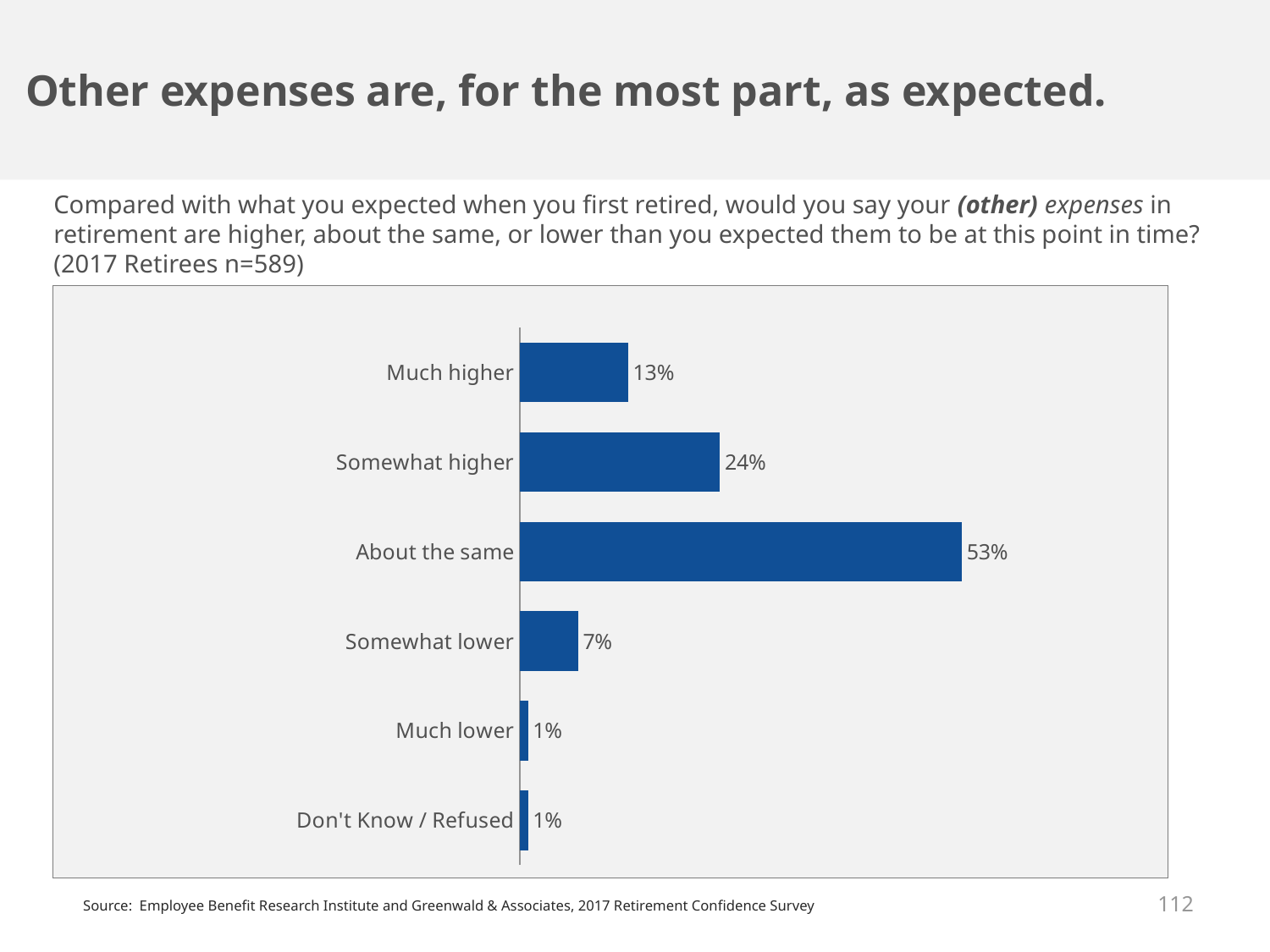
What percentage of retirees said their other expenses are about the same as expected? 53% Which response category has the highest percentage? About the same What percentage of retirees said their other expenses are somewhat lower than expected? 7% What is the sample size of 2017 retirees shown for this question? 589 What is the combined percentage of retirees who said their other expenses are much higher or somewhat higher than expected? 37% What is the difference in percentage points between 'About the same' and 'Somewhat higher'? 29 What kind of chart is shown on the slide? Bar chart How many response categories are shown in the chart? 6 What percentage of retirees said their other expenses are much higher than expected? 13% What is the difference in percentage points between 'Somewhat higher' and 'Much higher'? 11 What percentage of retirees answered Don't Know / Refused? 1% Which is larger, the percentage for 'Somewhat higher' or for 'Somewhat lower'? Somewhat higher